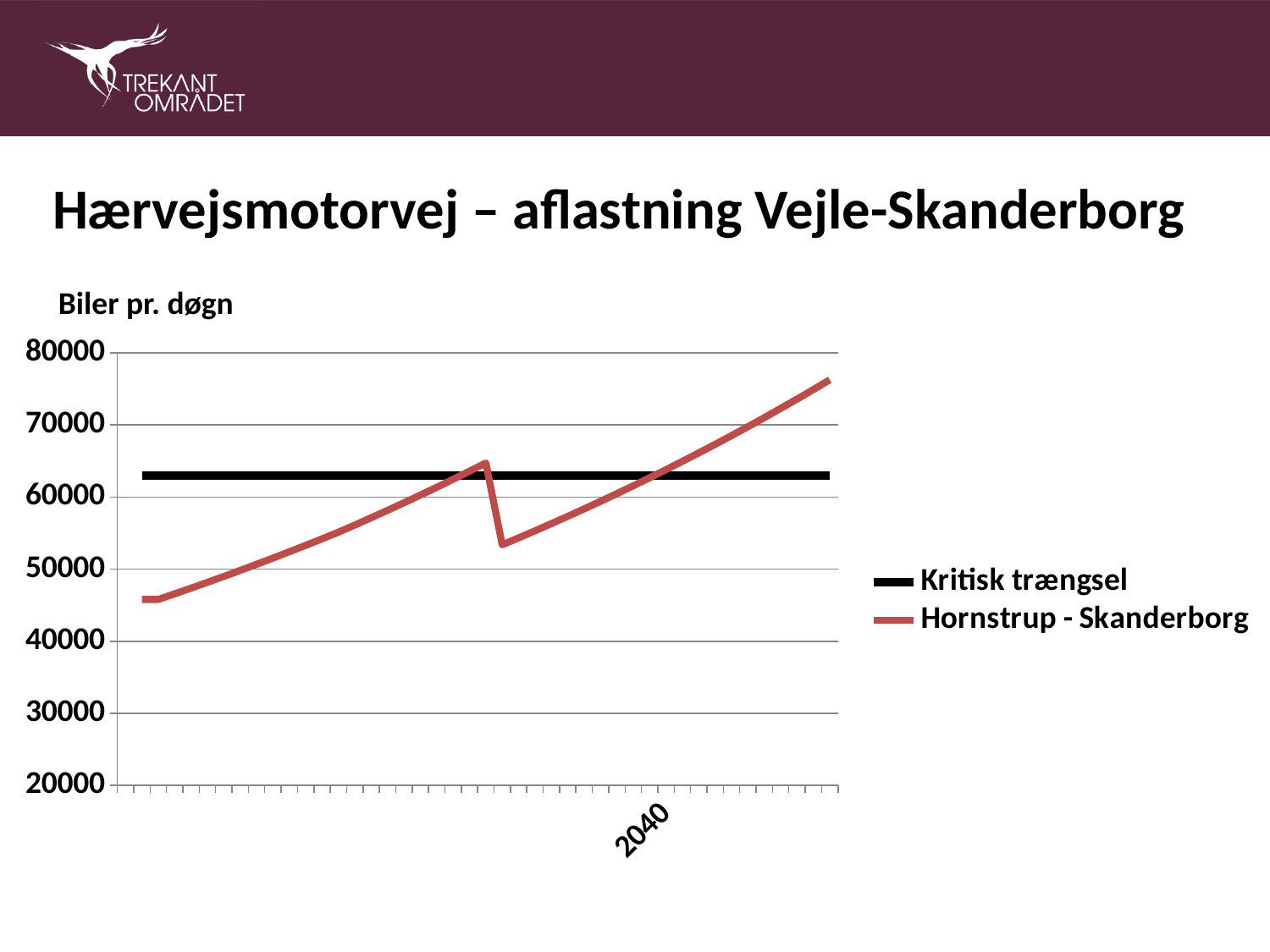
Does the Hornstrup - Skanderborg line overall rise or fall from the left end to the right end of the chart? rise Which series has the higher value at the left end of the chart, Kritisk trængsel or Hornstrup - Skanderborg? Kritisk trængsel Is the value of the Hornstrup - Skanderborg line at the right end of the chart greater or less than 70000? greater How many series does the legend list? 2 Is the value of the Kritisk trængsel line greater or less than 70000? less What kind of chart is shown on the slide? line chart Is the value of the Hornstrup - Skanderborg line at the left end of the chart greater or less than 50000? less Which series has the higher value at the right end of the chart, Kritisk trængsel or Hornstrup - Skanderborg? Hornstrup - Skanderborg What is the highest value shown on the vertical axis? 80000 What are the two series named in the legend? Kritisk trængsel; Hornstrup - Skanderborg What is the label shown above the vertical axis? Biler pr. døgn